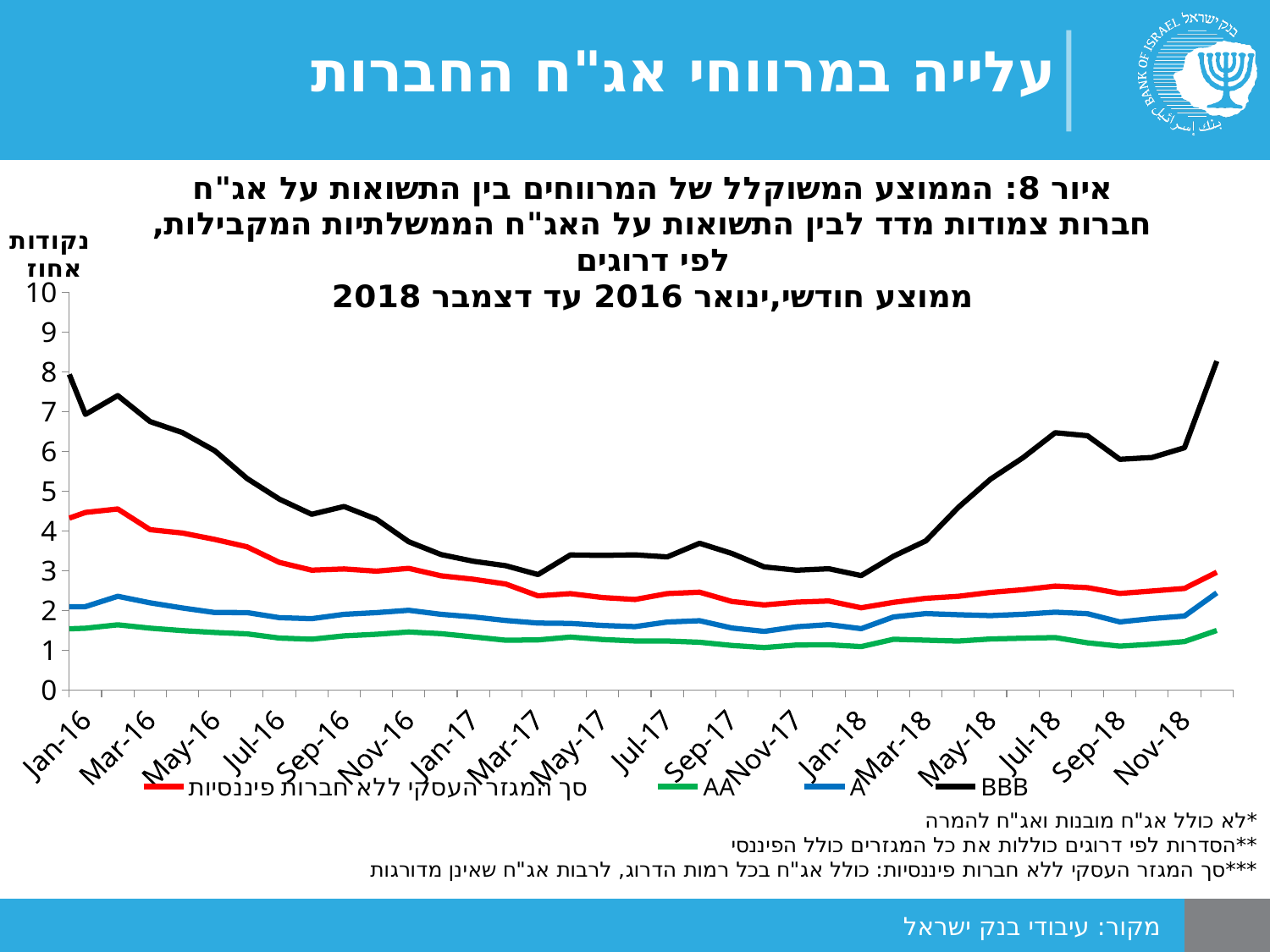
Is the value for BBB at Mar-17 greater or less than 4? less Does the BBB series rise or fall from Jan-18 to Jul-18? rise Is the value for BBB at Jan-16 greater or less than 6? greater What kind of chart is shown on the slide? line chart Is the value for AA at Jan-16 greater or less than 2? less What colour is the BBB series line? black At Jan-16, which series is higher, A or AA? A Which series has the lowest values across the whole period? AA How many series does the legend list? 4 Which series has the highest values across the whole period? BBB Does the BBB series rise or fall from Jan-16 to Mar-17? fall